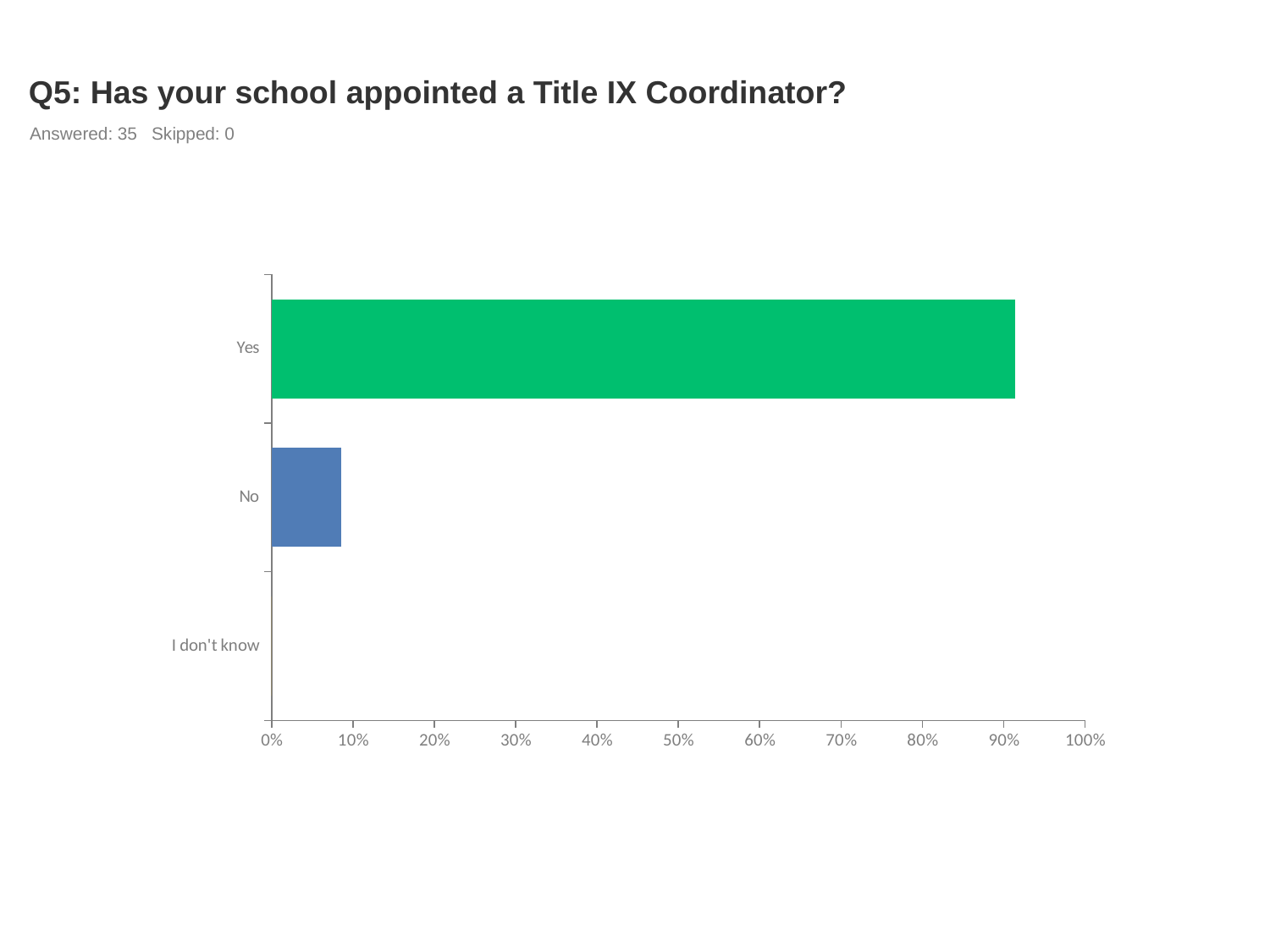
How many categories are shown on the chart? 3 Is the value for Yes greater or less than 90%? greater What kind of chart is shown on the slide? bar chart Which is larger, the value for No or the value for I don't know? No Is the value for Yes greater or less than 50%? greater Which category has the highest value? Yes Which category has the lowest value? I don't know What is the title of the chart? Q5: Has your school appointed a Title IX Coordinator? What colour is the bar for Yes? green Which is larger, the value for Yes or the value for No? Yes What is the maximum value shown on the x axis? 100% Is the value for No greater or less than 10%? less